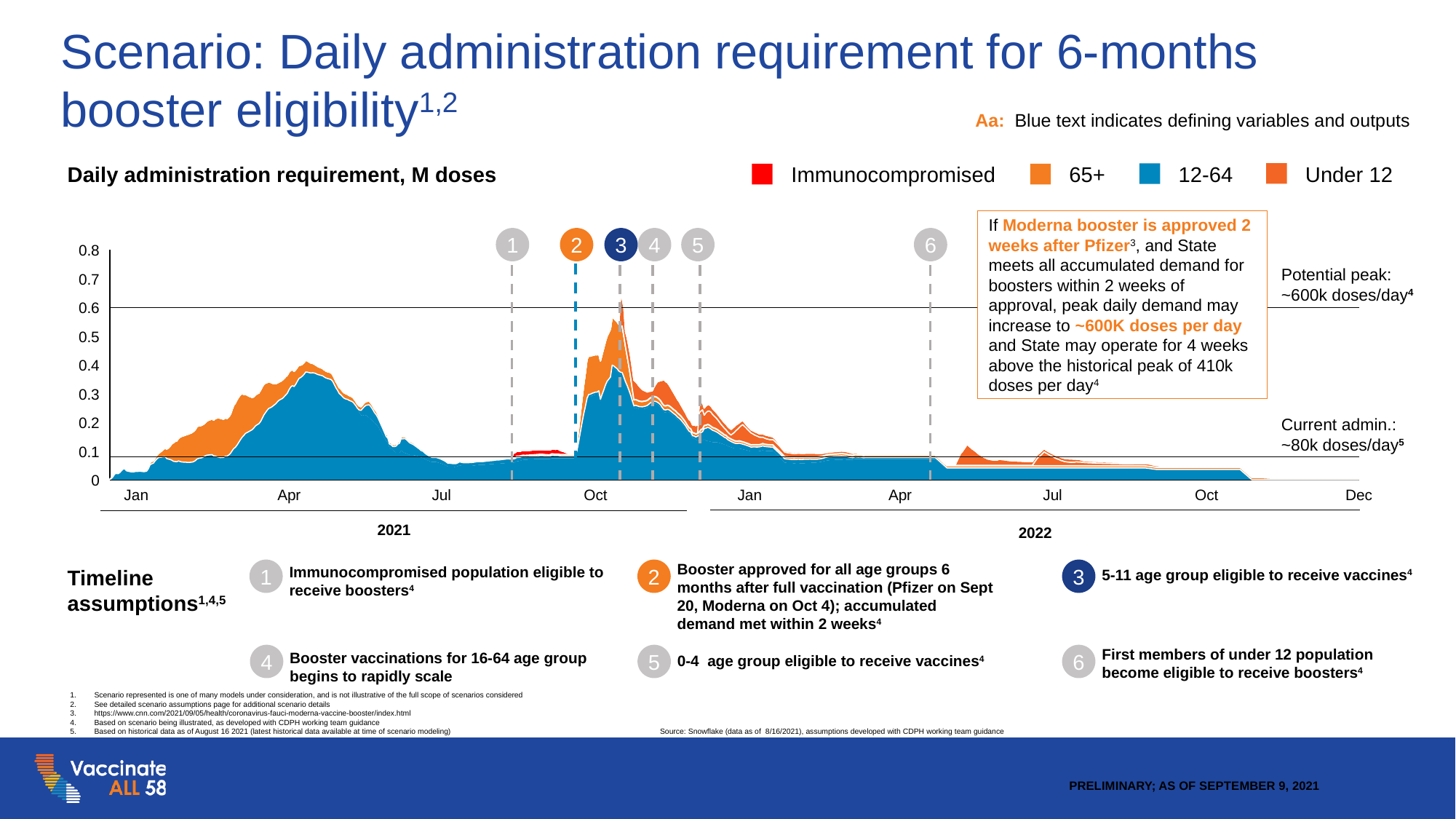
Which is higher: the peak in April 2021 or the peak in October 2021? October 2021 Is the daily administration requirement in July 2021 greater or less than 0.2 M doses? less How many numbered timeline markers are placed on the chart? 6 Is the peak daily administration requirement in October 2021 greater or less than 0.5 M doses? greater Is the daily administration requirement in December 2022 greater or less than 0.1 M doses? less Which series is shown in blue in the chart legend? 12-64 In which year does the chart reach its highest peak? 2021 Do the values rise or fall between April 2021 and July 2021? Fall What is the title of the chart? Daily administration requirement, M doses How many series does the chart legend list? 4 What kind of chart is shown on the slide? Stacked area chart What is the highest value shown on the y axis? 0.8